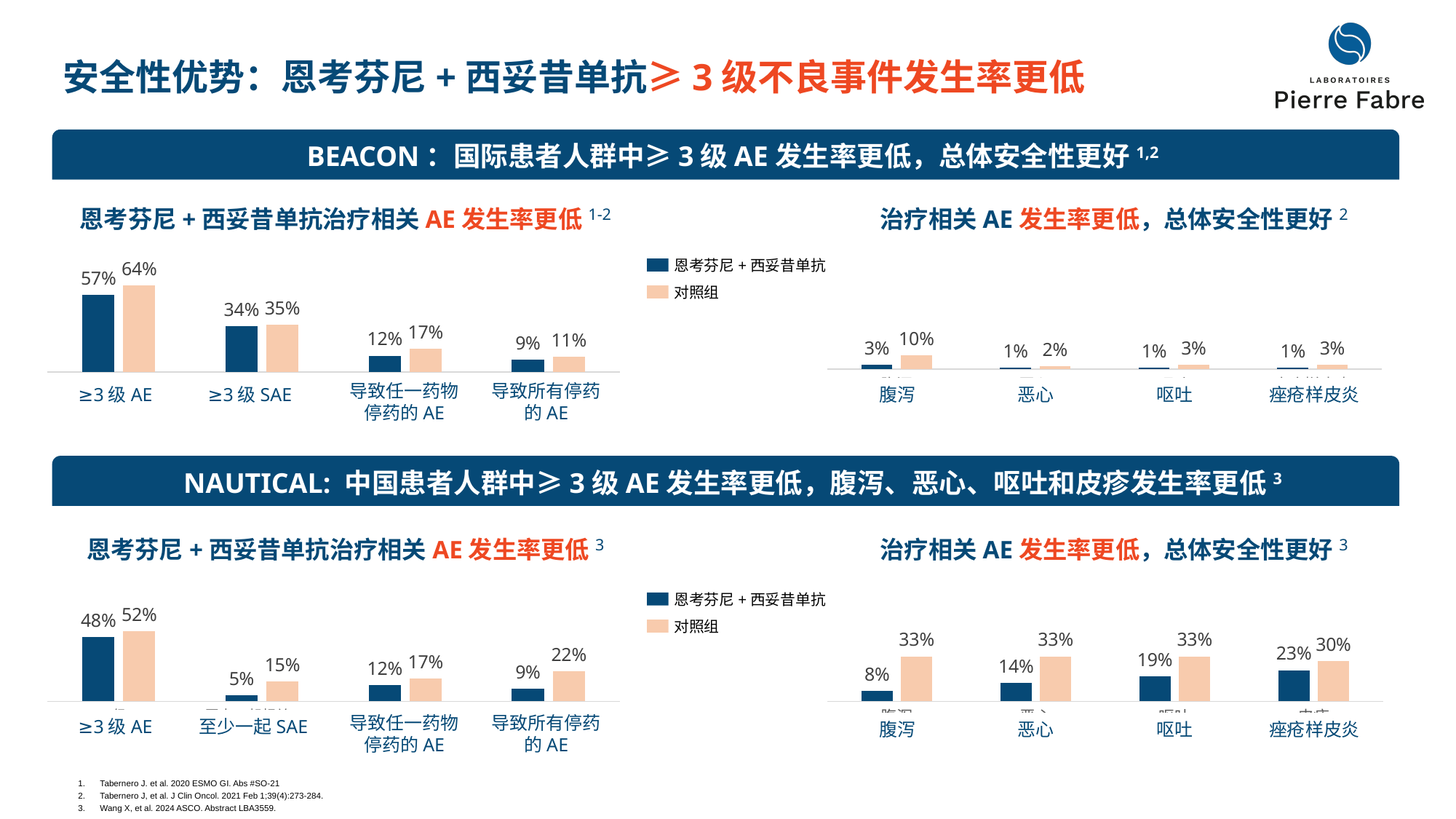
In the NAUTICAL bottom-right chart, what is the value for 恩考芬尼 + 西妥昔单抗 in the 呕吐 category? 19% In the BEACON top-right chart, which category has the highest value for 恩考芬尼 + 西妥昔单抗? 腹泻 In the BEACON top-left chart, what is the difference between 对照组 and 恩考芬尼 + 西妥昔单抗 for ≥3 级 AE? 7% In the BEACON top-left chart, what is the value for 恩考芬尼 + 西妥昔单抗 in the ≥3 级 AE category? 57% What kind of chart is the NAUTICAL bottom-left chart? Bar chart In the NAUTICAL bottom-right chart, which is larger for 痤疮样皮炎: 恩考芬尼 + 西妥昔单抗 or 对照组? 对照组 In the BEACON top-right chart, what is the value for 对照组 in the 腹泻 category? 10% In the NAUTICAL bottom-left chart, what is the difference between 对照组 and 恩考芬尼 + 西妥昔单抗 for 导致所有停药的 AE? 13% In the BEACON top-left chart, what is the value for 对照组 in the ≥3 级 SAE category? 35% In the NAUTICAL bottom-right chart, which category has the lowest value for 恩考芬尼 + 西妥昔单抗? 腹泻 How many series does the legend of the BEACON top-right chart list? 2 In the NAUTICAL bottom-left chart, what is the value for 恩考芬尼 + 西妥昔单抗 in the 至少一起 SAE category? 5%